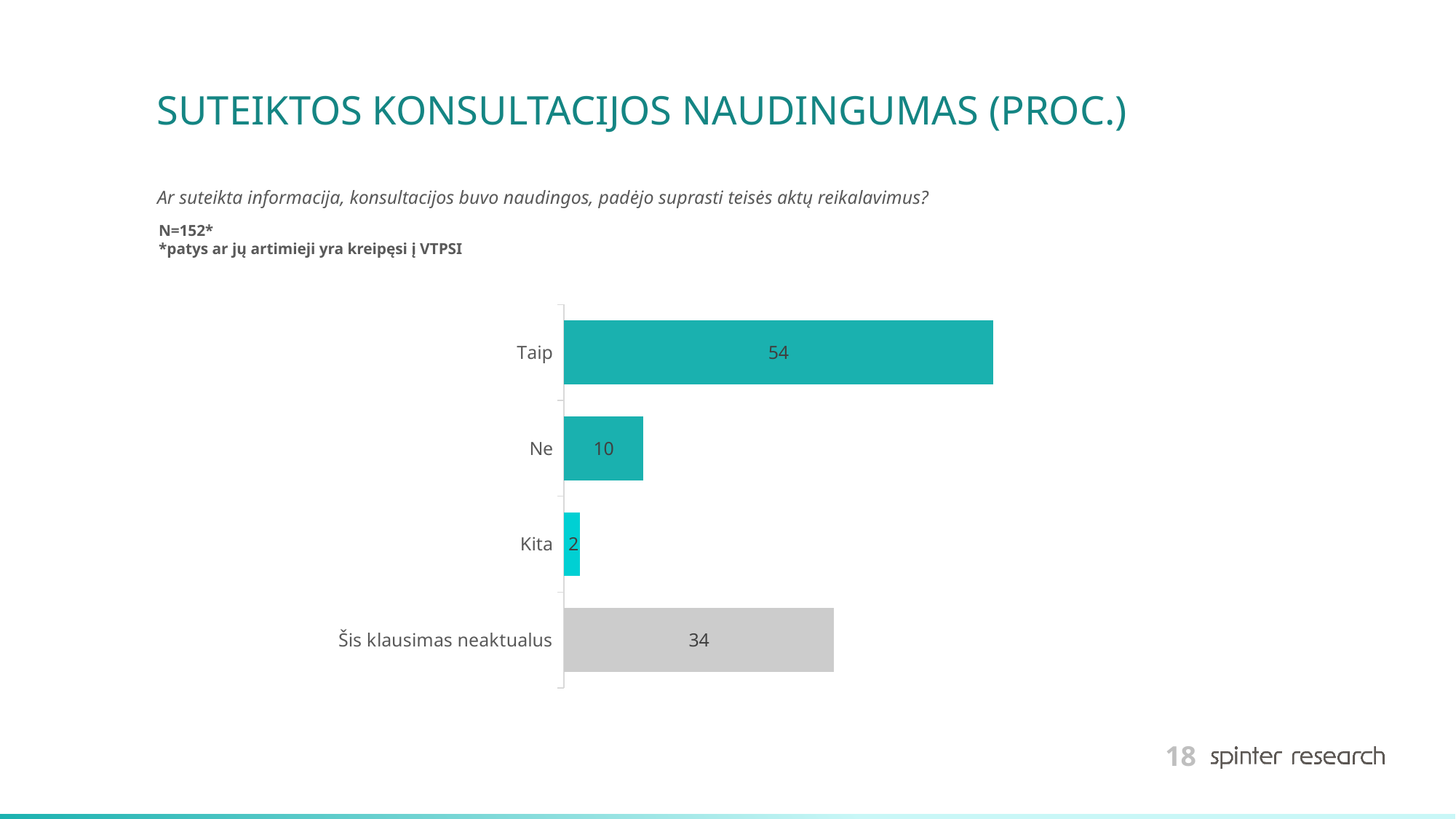
Which category has the lowest value? Kita What is the value for "Taip"? 54 What is the difference between the values for "Taip" and "Šis klausimas neaktualus"? 20 What is the value for "Kita"? 2 Which category has the highest value? Taip What kind of chart is shown on the slide? Bar chart How many categories are shown in the chart? 4 What is the sample size (N) stated on the slide? N=152* What is the value for "Šis klausimas neaktualus"? 34 What is the difference between the values for "Ne" and "Kita"? 8 What is the value for "Ne"? 10 Which is larger, the value for "Ne" or the value for "Šis klausimas neaktualus"? Šis klausimas neaktualus